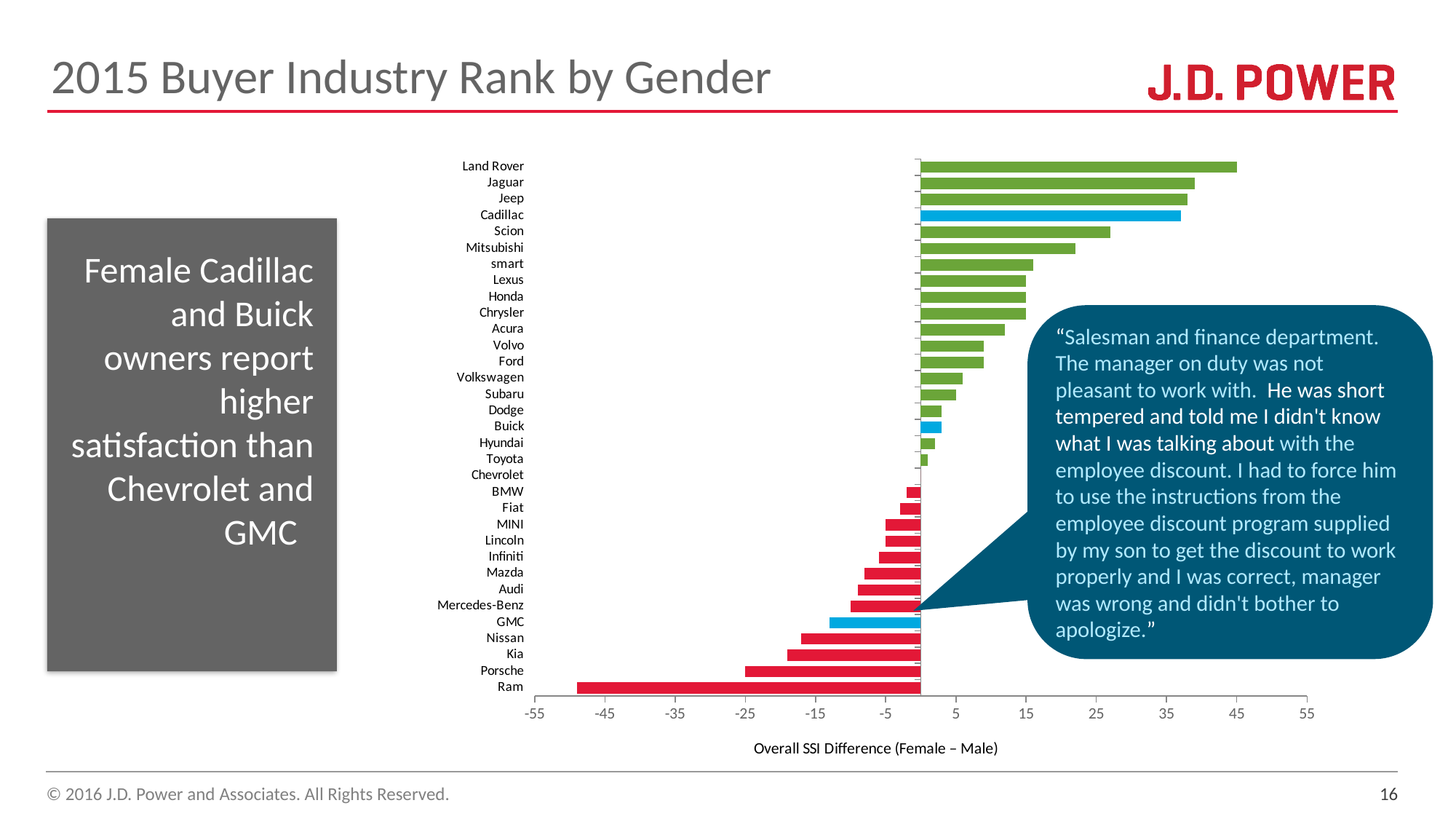
How many brands are plotted in the chart? 33 Is the value for Cadillac greater or less than 25? greater What is the title of the horizontal axis? Overall SSI Difference (Female – Male) Which brand has the larger Overall SSI Difference, Jeep or Scion? Jeep Is the value for Kia greater or less than -15? less What kind of chart is shown on the slide? bar chart Is the value for Land Rover greater or less than 35? greater Which brand has the larger Overall SSI Difference, Porsche or Ram? Porsche Which brand has the lowest Overall SSI Difference (Female – Male)? Ram Which brand has the highest Overall SSI Difference (Female – Male)? Land Rover